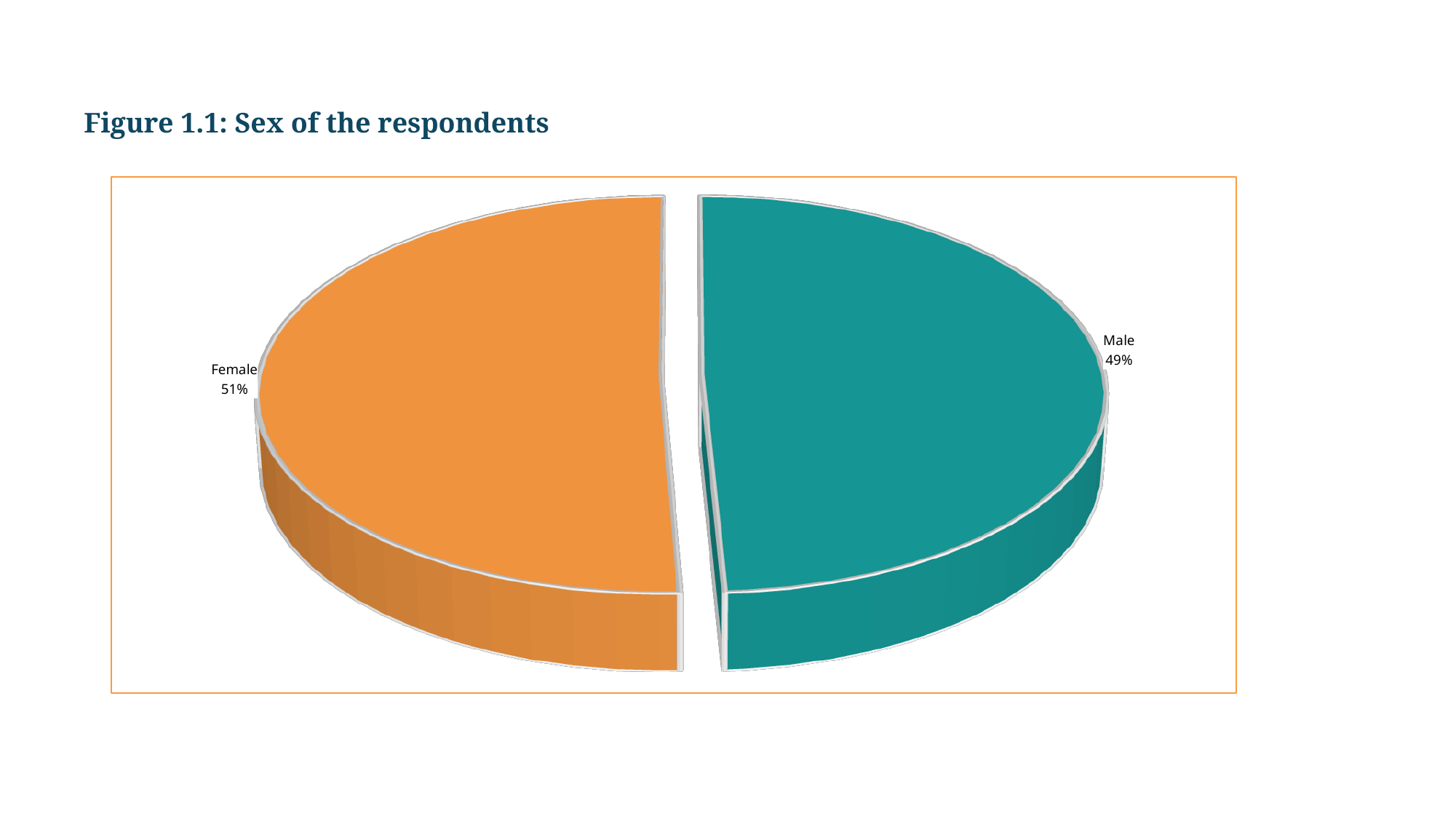
How many categories does the pie chart show? 2 Which category has the smaller share of respondents? Male What percentage of respondents are female? 51% What share of the pie does the Male slice represent? 49% What is the title of the figure on the slide? Figure 1.1: Sex of the respondents Is the Female share larger or smaller than the Male share? larger Which category has the larger share of respondents? Female What percentage of respondents are male? 49% What kind of chart is shown on the slide? pie chart What is the difference in percentage points between the Female and Male shares? 2 What colour is the Female slice of the pie chart? orange